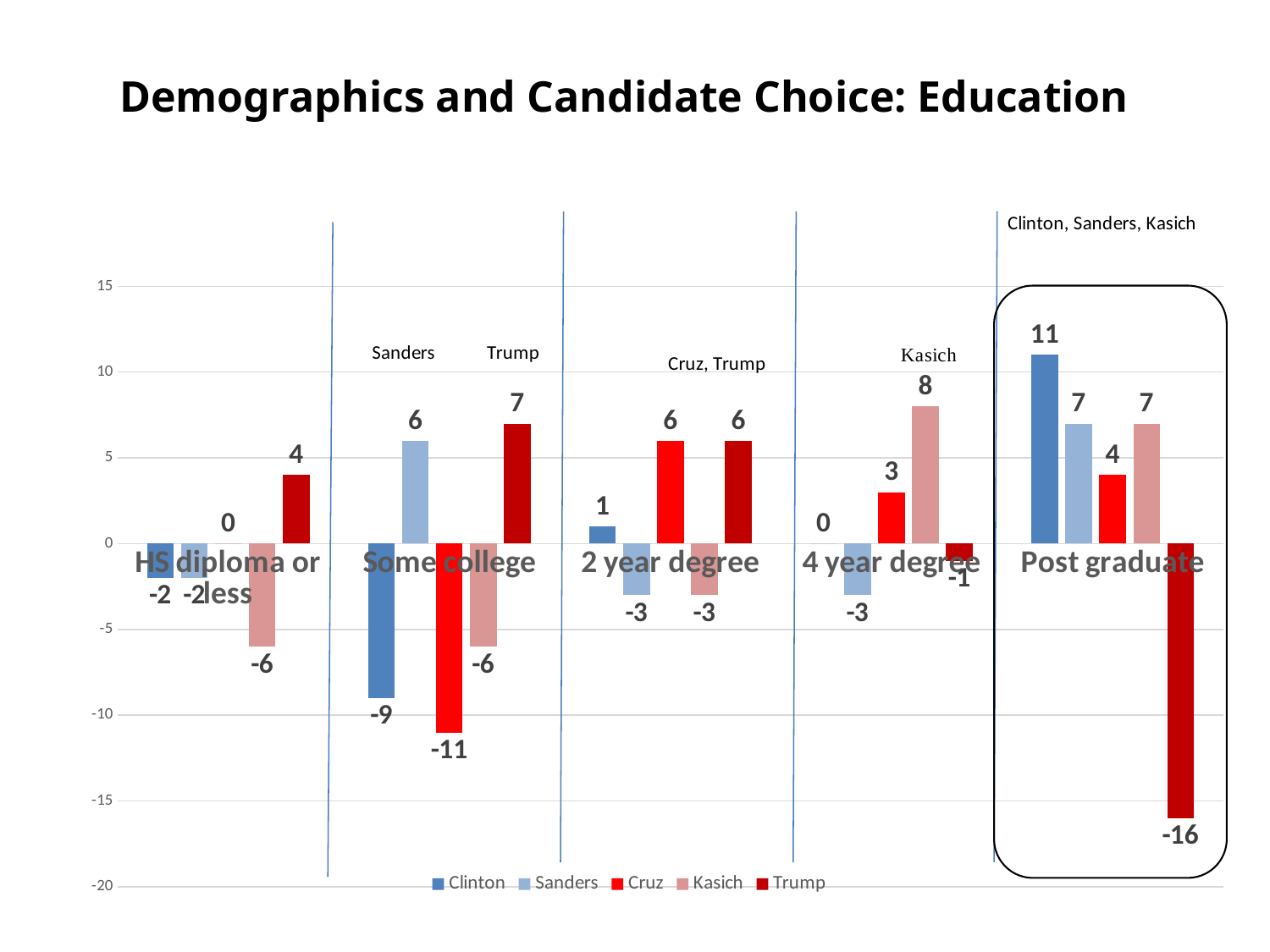
Which candidate has the highest value in the Post graduate category? Clinton What is the value for Trump in the Post graduate category? -16 What is the title of the slide? Demographics and Candidate Choice: Education What is the value for Kasich in the 4 year degree category? 8 What is the difference between Clinton's and Trump's values in the Post graduate category? 27 How many series does the legend list? 5 How many education categories are shown on the x axis? 5 What is the value for Clinton in the Some college category? -9 What is the value for Cruz in the 2 year degree category? 6 Which is larger in the Some college category, Sanders' value or Trump's value? Trump's value Which candidate has the lowest value in the Some college category? Cruz What kind of chart is shown on the slide? Bar chart